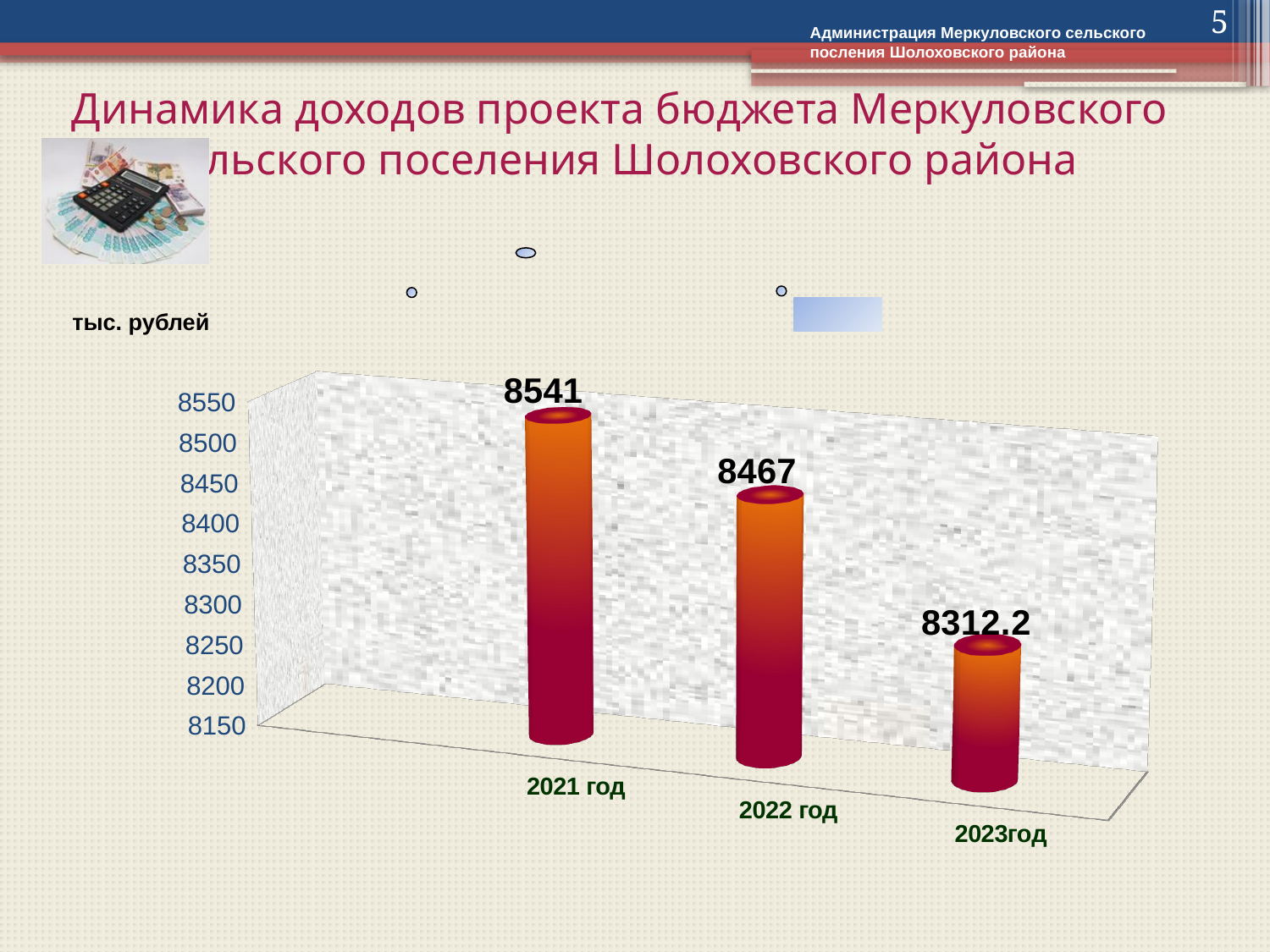
What is the value for 2023год? 8312.2 What is the value for 2021 год? 8541 Which year has the highest value? 2021 год How many years are shown on the chart? 3 What is the difference between the values for 2022 год and 2023год? 154.8 Do the values rise or fall from 2021 год to 2023год? fall Which year has the lowest value? 2023год What is the difference between the values for 2021 год and 2022 год? 74 What is the value for 2022 год? 8467 What kind of chart is shown on the slide? bar chart Is the value for 2023год greater or less than 8350? less Which is larger, the value for 2021 год or the value for 2023год? 2021 год